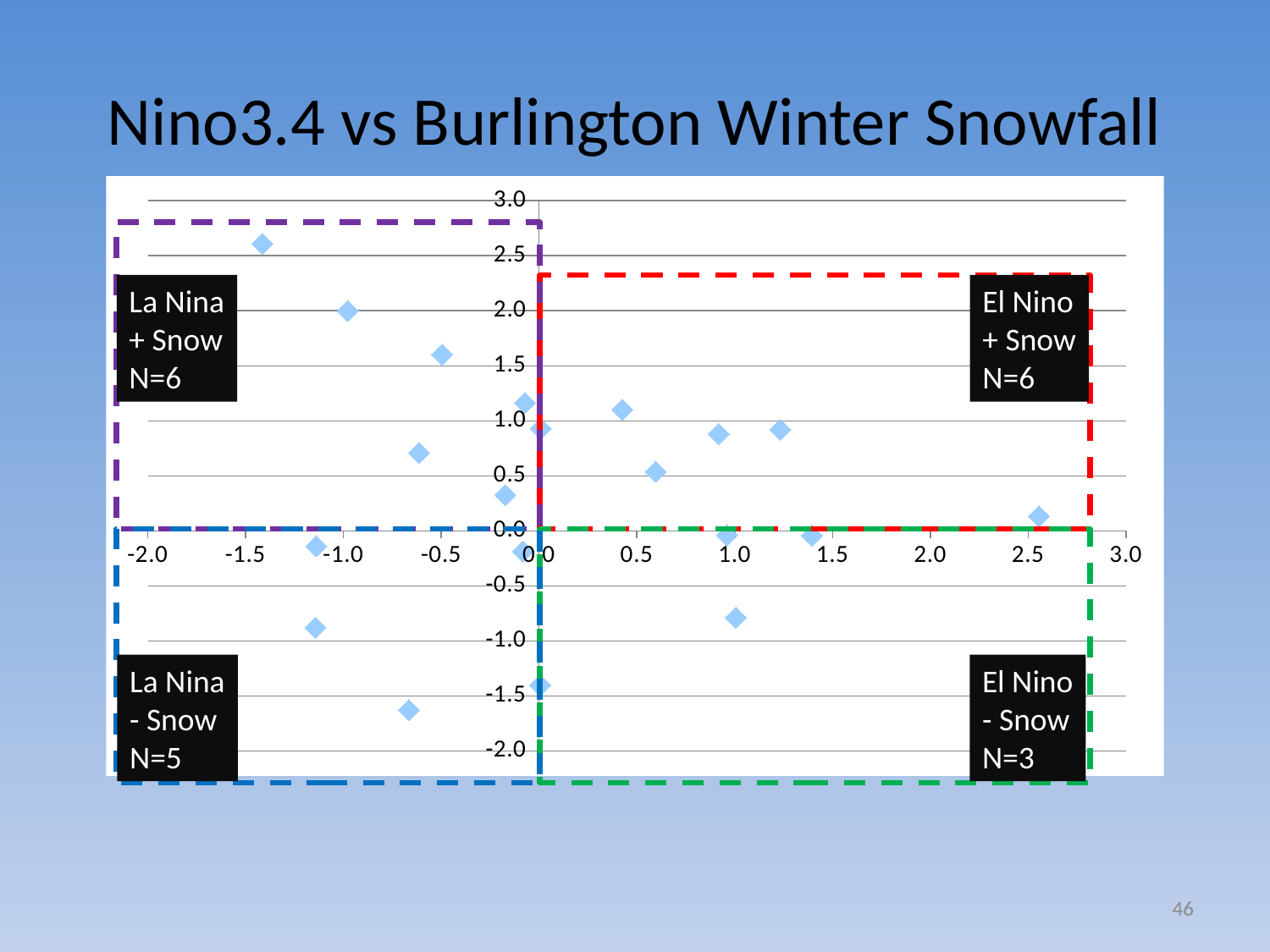
Which quadrant has more points, La Nina - Snow or El Nino - Snow? La Nina - Snow How many dashed quadrant boxes are drawn on the chart? 4 Which labelled quadrant has the fewest points? El Nino - Snow How many points (N) are in the La Nina + Snow quadrant? 6 What kind of chart is shown on the slide? scatter plot How many points (N) are in the La Nina - Snow quadrant? 5 What is the title of the chart? Nino3.4 vs Burlington Winter Snowfall What is the highest value shown on the x axis? 3.0 What is the difference in N between the La Nina - Snow and El Nino - Snow quadrants? 2 What is the total N across all four labelled quadrants? 20